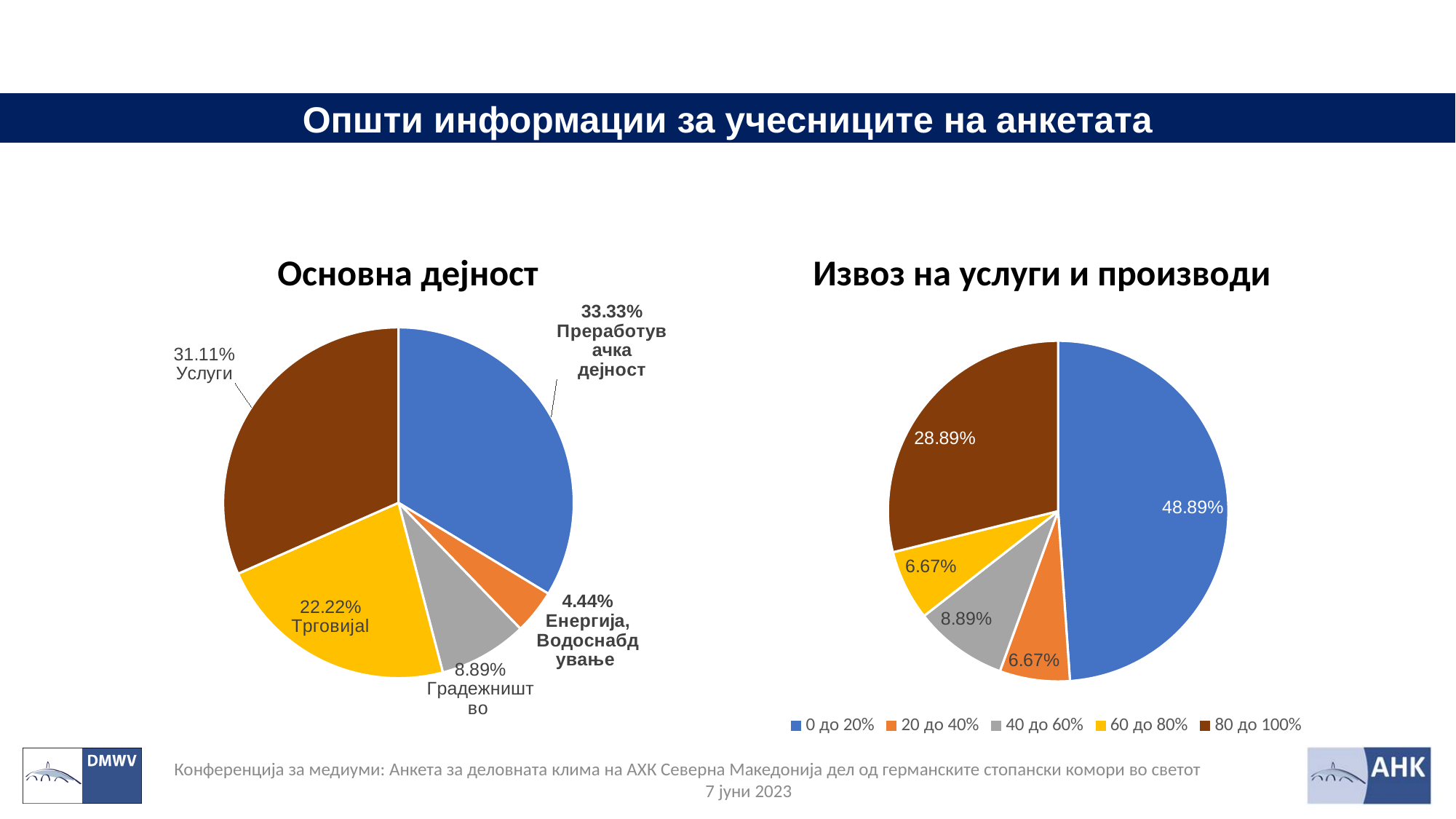
In the chart titled "Извоз на услуги и производи", what share of the pie is the 0 до 20% category? 48.89% In the chart titled "Извоз на услуги и производи", which is larger, the 40 до 60% slice or the 60 до 80% slice? 40 до 60% In the chart titled "Основна дејност", what share of the pie is Услуги? 31.11% What type of chart is the chart titled "Извоз на услуги и производи"? Pie chart In the chart titled "Извоз на услуги и производи", what share of the pie is the 80 до 100% category? 28.89% In the chart titled "Основна дејност", how many slices does the pie have? 5 In the chart titled "Основна дејност", what is the difference in percentage points between Преработувачка дејност and Услуги? 2.22 In the chart titled "Основна дејност", what share of the pie is Трговија? 22.22% In the chart titled "Основна дејност", which category has the smallest slice? Енергија, Водоснабдување In the chart titled "Извоз на услуги и производи", how many categories does the legend list? 5 In the chart titled "Извоз на услуги и производи", which category has the largest slice? 0 до 20% In the chart titled "Основна дејност", which category has the largest slice? Преработувачка дејност